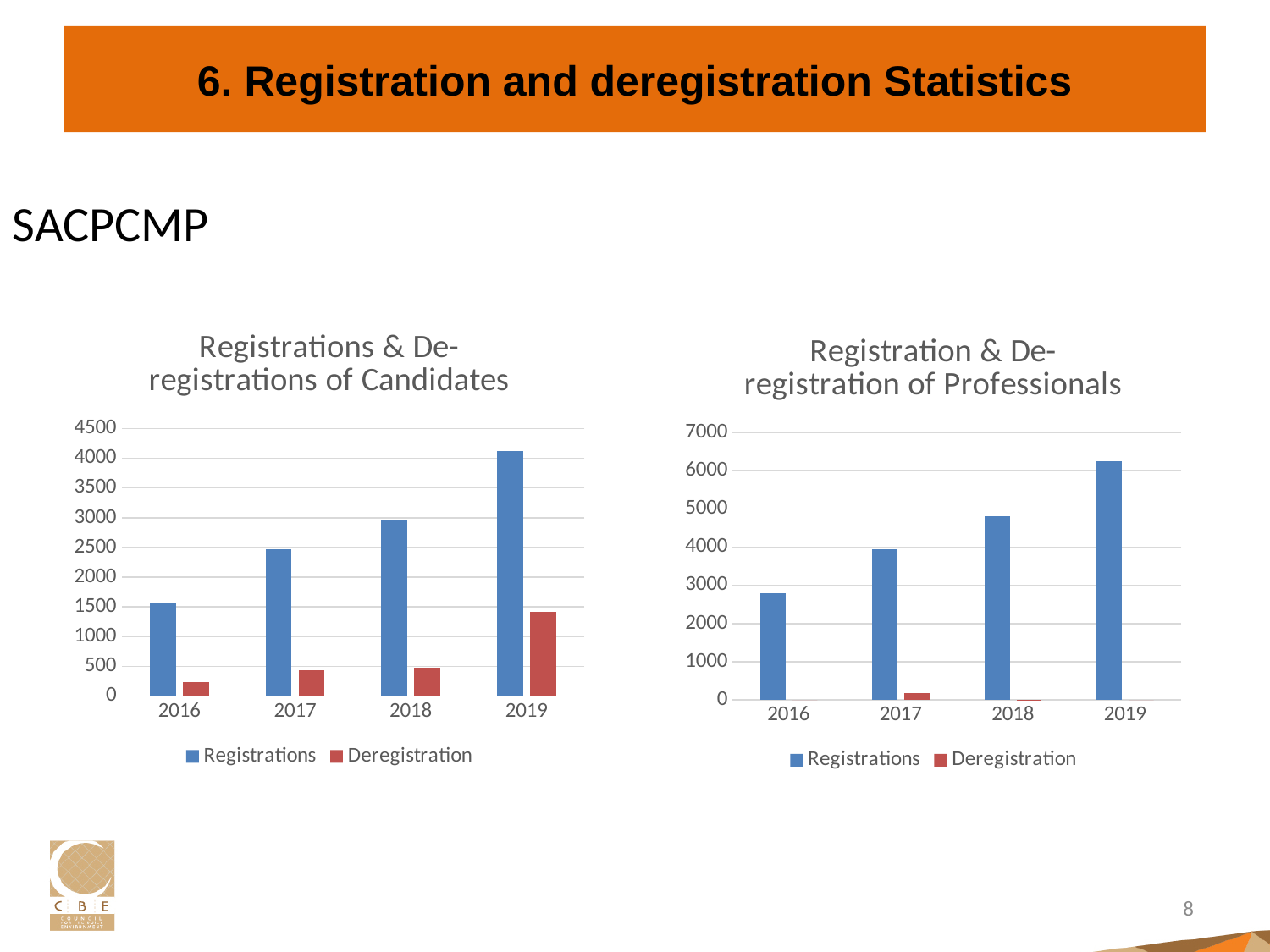
In the 'Registrations & De-registrations of Candidates' chart, is the Deregistration value for 2019 greater or less than 1000? greater In the 'Registrations & De-registrations of Candidates' chart, how many years are shown on the x axis? 4 In the 'Registration & De-registration of Professionals' chart, which year has more Registrations, 2017 or 2018? 2018 In the 'Registrations & De-registrations of Candidates' chart, is the Registrations value for 2019 greater or less than 4000? greater In the 'Registration & De-registration of Professionals' chart, which year has the highest Registrations? 2019 In the 'Registrations & De-registrations of Candidates' chart, do Registrations rise or fall from 2016 to 2019? rise In the 'Registration & De-registration of Professionals' chart, is the Registrations value for 2016 greater or less than 3000? less In the 'Registrations & De-registrations of Candidates' chart, what kind of chart is shown? bar chart In the 'Registrations & De-registrations of Candidates' chart, which year has the highest Registrations? 2019 In the 'Registration & De-registration of Professionals' chart, which year has the highest Deregistration? 2017 In the 'Registrations & De-registrations of Candidates' chart, how many series does the legend list? 2